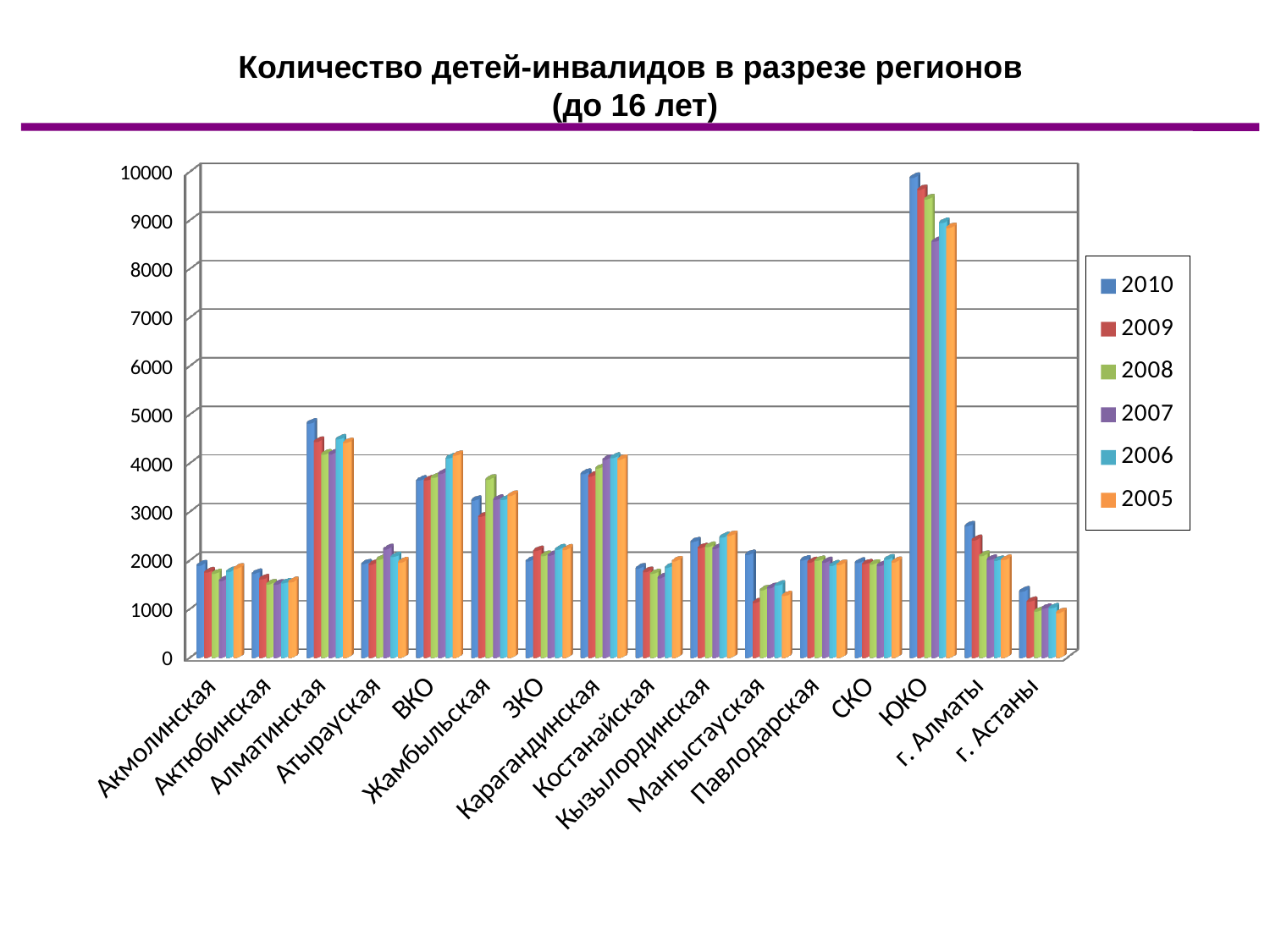
Which region has the lowest value for the 2010 series? г. Астаны Is the 2010 value for Алматинская greater or less than 4000? greater What is the title of the chart? Количество детей-инвалидов в разрезе регионов (до 16 лет) Is the 2010 value for г. Астаны greater or less than 2000? less Is the 2009 value for Мангыстауская greater or less than 2000? less Which is larger, the 2010 value for Алматинская or the 2010 value for ВКО? Алматинская What kind of chart is shown on the slide? bar chart How many series does the legend list? 6 Which year is listed first in the legend? 2010 Which region has the highest values in the chart? ЮКО How many regions (categories) are shown on the x axis of the chart? 16